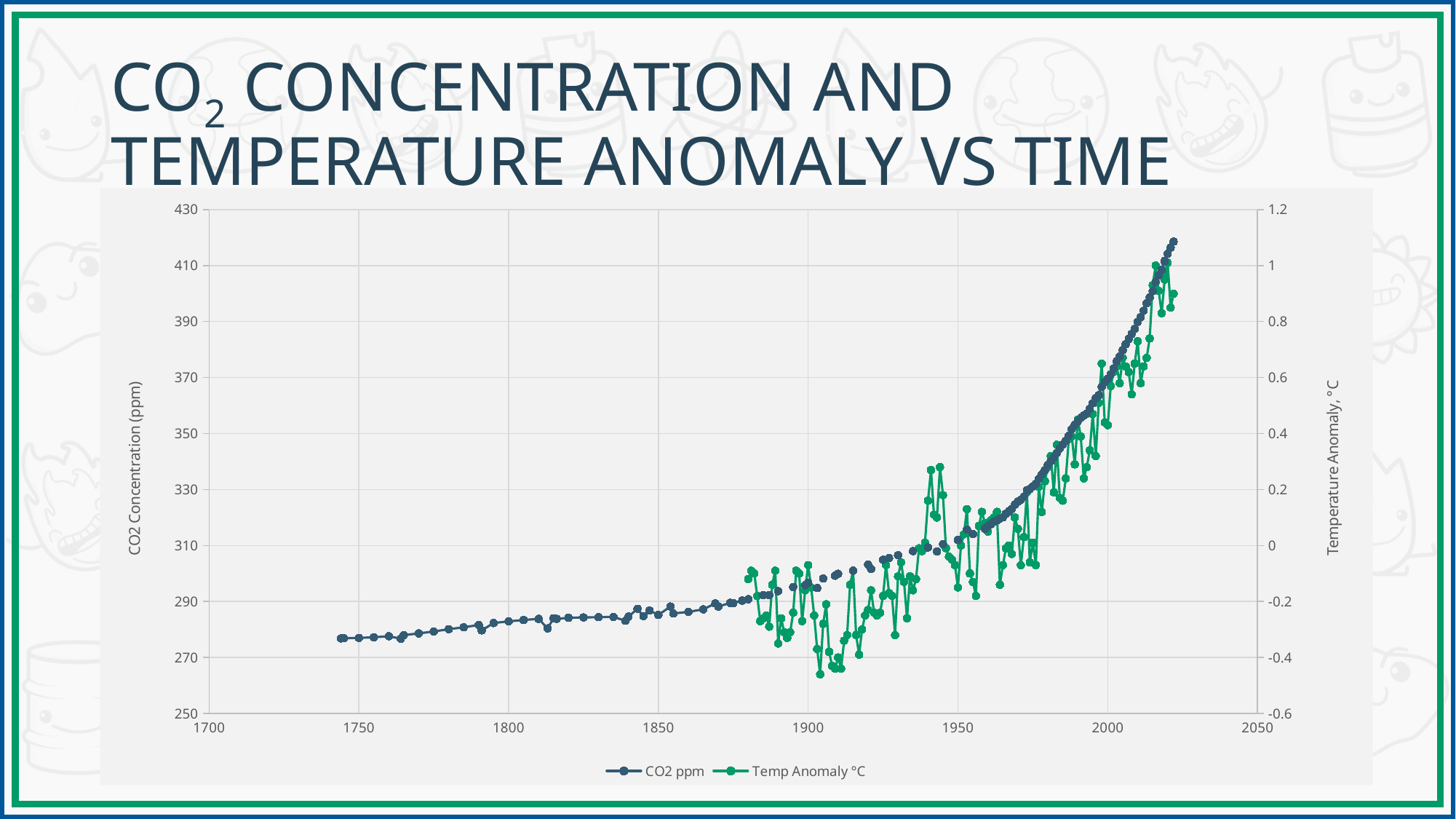
Which is larger, the Temp Anomaly °C value around 2010 or around 1910? Around 2010 What are the two series named in the legend? CO2 ppm and Temp Anomaly °C What is the title of the left vertical axis? CO2 Concentration (ppm) Is the CO2 ppm value around the year 1750 greater or less than 290? less Which is larger, the CO2 ppm value around 2000 or the CO2 ppm value around 1900? Around 2000 What kind of chart is shown on the slide? Line chart Is the Temp Anomaly °C value around the year 1910 greater or less than -0.2? less How many series does the legend list? 2 Is the CO2 ppm value around the year 1900 greater or less than 310? less Does the CO2 ppm series rise or fall as the years increase along the x axis? Rise